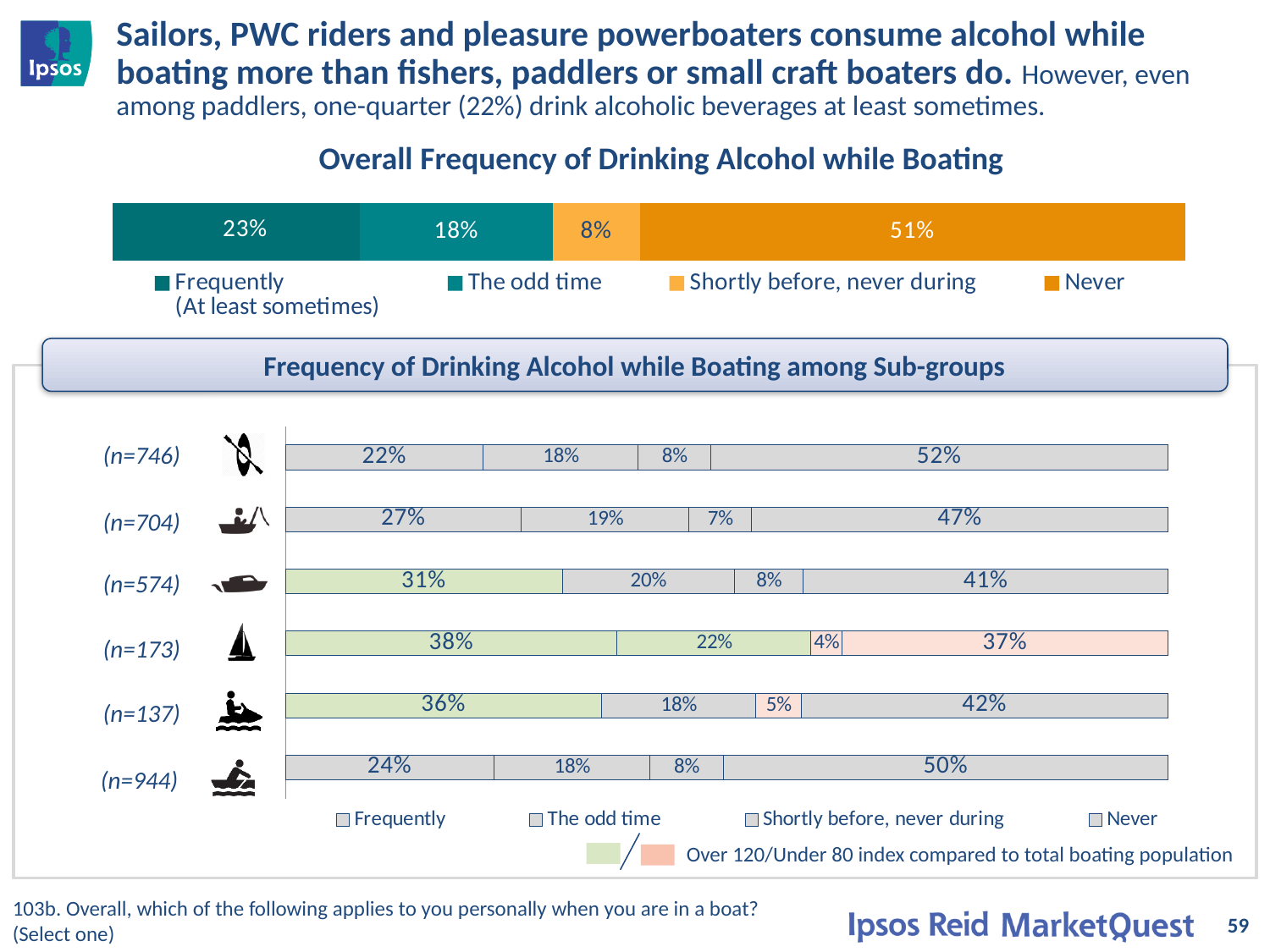
In the Sub-groups chart, which sub-group has the lowest Never value? n=173 How many series does the legend of the Overall Frequency of Drinking Alcohol while Boating chart list? 4 In the Sub-groups chart, which has the larger Frequently value: the sub-group with n=137 or the sub-group with n=944? n=137 How many sub-group bars are shown in the Frequency of Drinking Alcohol while Boating among Sub-groups chart? 6 In the Sub-groups chart, which sub-group has the highest Frequently value? n=173 In the Sub-groups chart, what is the difference between the Never value for n=746 and the Never value for n=173? 15 percentage points In the Overall Frequency of Drinking Alcohol while Boating chart, what percentage is shown for Frequently (At least sometimes)? 23% In the Overall Frequency of Drinking Alcohol while Boating chart, which category has the largest segment? Never In the Sub-groups chart, what is the Never value for the sub-group with n=574? 41% What kind of chart is the Overall Frequency of Drinking Alcohol while Boating chart? Stacked bar chart In the Sub-groups chart, what is the Frequently value for the sub-group with n=173? 38% In the Overall Frequency of Drinking Alcohol while Boating chart, what percentage is shown for Never? 51%